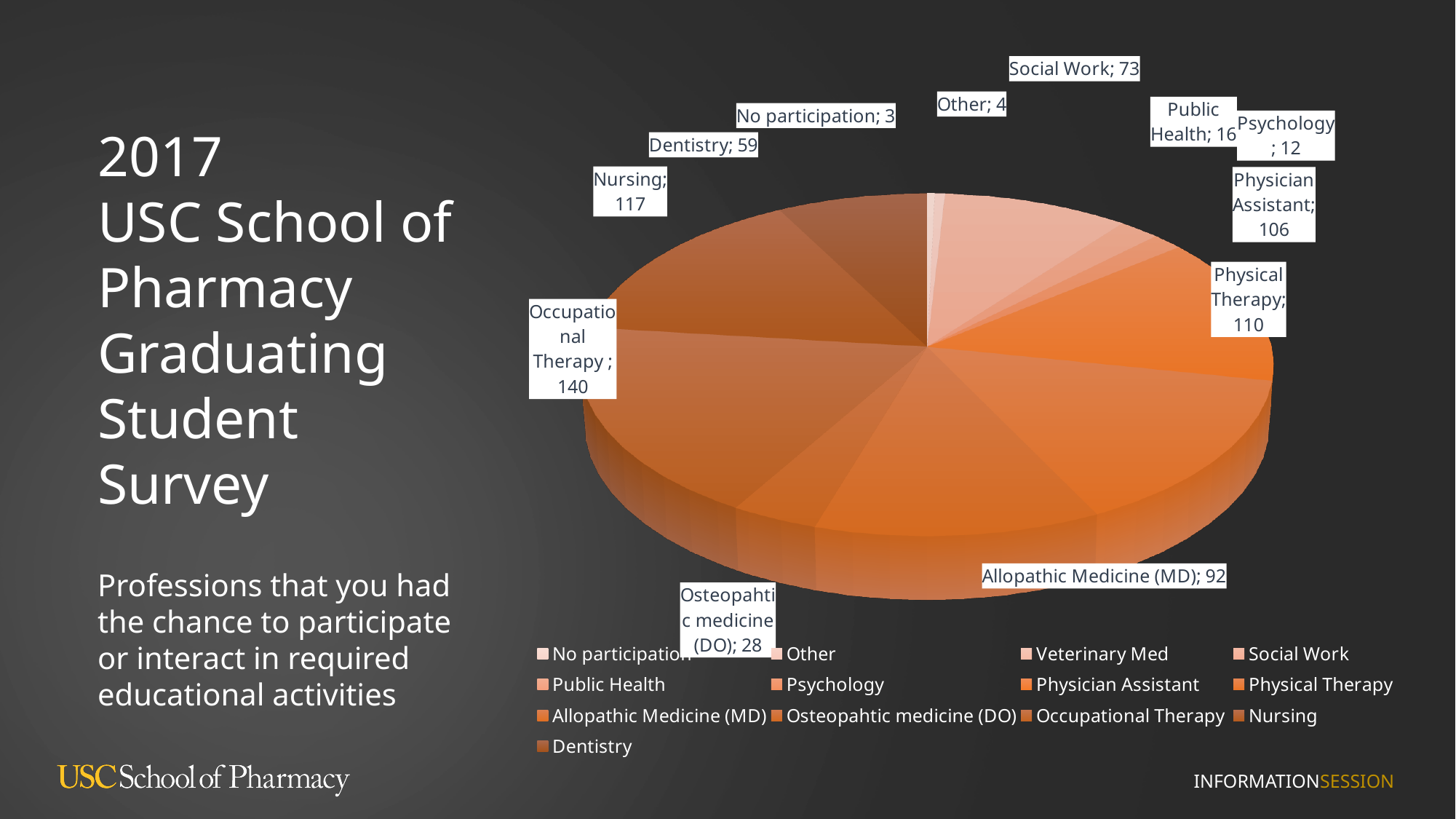
Which has a larger value, Dentistry or Social Work? Social Work Which has a larger value, Physical Therapy or Physician Assistant? Physical Therapy What is the difference between the values for Physician Assistant and Allopathic Medicine (MD)? 14 What value is shown for Osteopathic medicine (DO) in the pie chart? 28 What value is shown for Social Work in the pie chart? 73 How many categories does the legend of the pie chart list? 13 What value is shown for Allopathic Medicine (MD) in the pie chart? 92 What type of chart is shown on the slide? Pie chart What is the difference between the values for Occupational Therapy and Nursing? 23 What value is shown for Occupational Therapy in the pie chart? 140 What value is shown for Nursing in the pie chart? 117 Which profession has the largest slice in the pie chart? Occupational Therapy